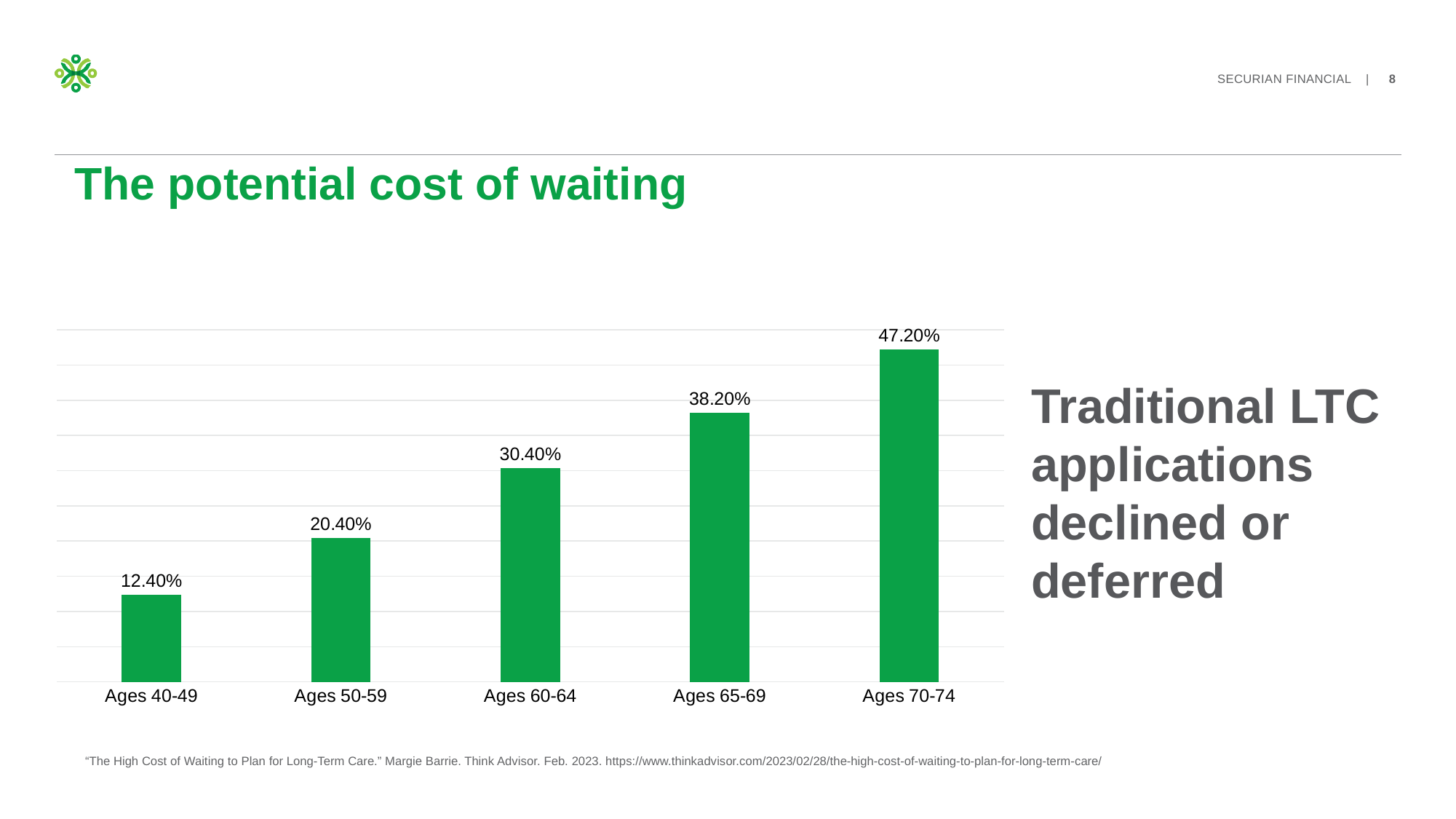
What kind of chart is shown on the slide? Bar chart Which age group has the highest value? Ages 70-74 What is the title of the slide containing the chart? The potential cost of waiting How many age groups are shown in the chart? 5 Which is larger, the value for Ages 65-69 or the value for Ages 60-64? Ages 65-69 What is the value for Ages 70-74? 47.20% What is the difference between the values for Ages 50-59 and Ages 40-49? 8.00% Which age group has the lowest value? Ages 40-49 What is the value for Ages 60-64? 30.40% Do the values rise or fall as age increases along the x axis? Rise What is the difference between the values for Ages 70-74 and Ages 65-69? 9.00% What is the value for Ages 40-49? 12.40%